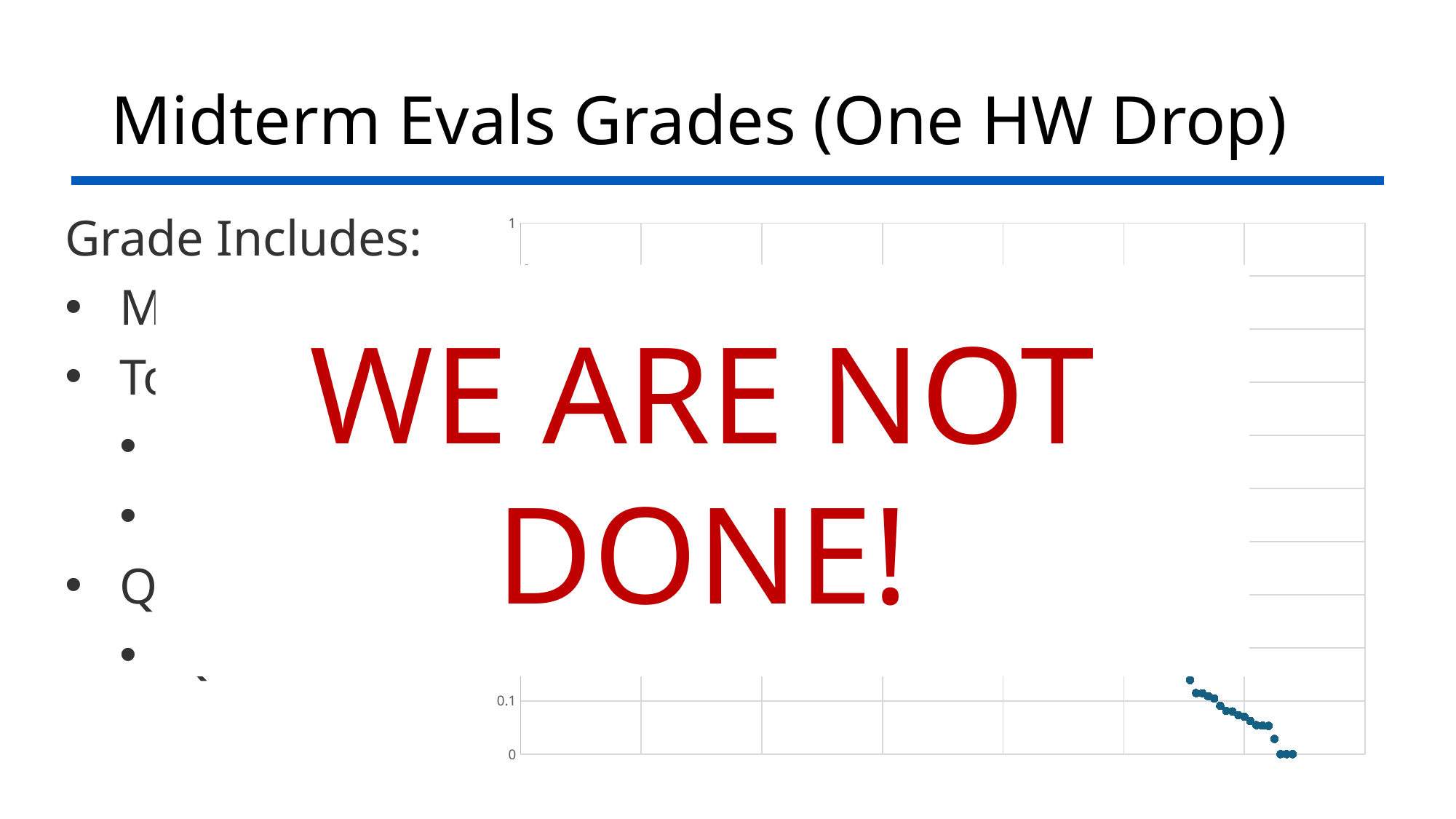
What value do the rightmost plotted points reach on the y axis? 0 What is the highest tick value shown on the chart's y axis? 1 Are the visible plotted points greater or less than 1 on the y axis? less What kind of chart is shown on the slide? scatter chart Is the value of the leftmost visible point greater or less than 0.1? greater What is the title of the slide containing the chart? Midterm Evals Grades (One HW Drop) Do the visible plotted points rise or fall from left to right? fall